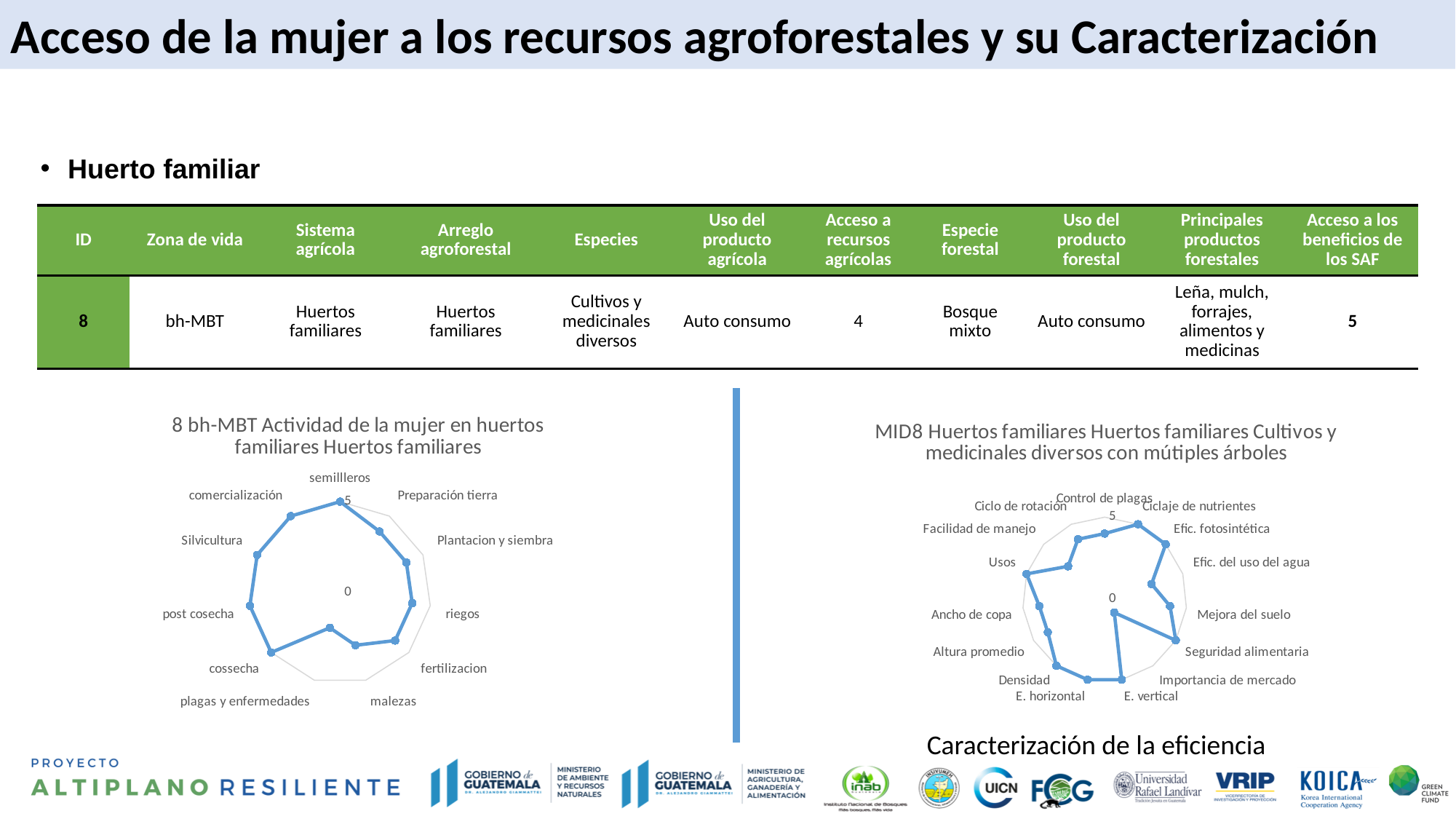
What kind of chart is the chart on the right, titled 'MID8 Huertos familiares Huertos familiares Cultivos y medicinales diversos con mútiples árboles'? Radar chart In the left chart ('8 bh-MBT Actividad de la mujer en huertos familiares'), is the value for plagas y enfermedades greater or less than 5? less In the left chart ('8 bh-MBT Actividad de la mujer en huertos familiares'), how many categories (axes) are plotted? 11 In the left chart ('8 bh-MBT Actividad de la mujer en huertos familiares'), which is larger: the value for semilleros or the value for plagas y enfermedades? semilleros In the left chart ('8 bh-MBT Actividad de la mujer en huertos familiares'), which category has the lowest value? plagas y enfermedades What kind of chart is the chart on the left, titled '8 bh-MBT Actividad de la mujer en huertos familiares Huertos familiares'? Radar chart In the right chart ('MID8 Huertos familiares...'), which is larger: the value for Usos or the value for Importancia de mercado? Usos What is the maximum value shown on the radial axis of the left chart ('8 bh-MBT Actividad de la mujer en huertos familiares')? 5 What is the title of the chart on the left side of the slide? 8 bh-MBT Actividad de la mujer en huertos familiares Huertos familiares In the right chart ('MID8 Huertos familiares...'), which is larger: the value for Seguridad alimentaria or the value for Mejora del suelo? Seguridad alimentaria In the right chart ('MID8 Huertos familiares...'), which category has the lowest value? Importancia de mercado In the right chart ('MID8 Huertos familiares...'), how many categories (axes) are plotted? 15